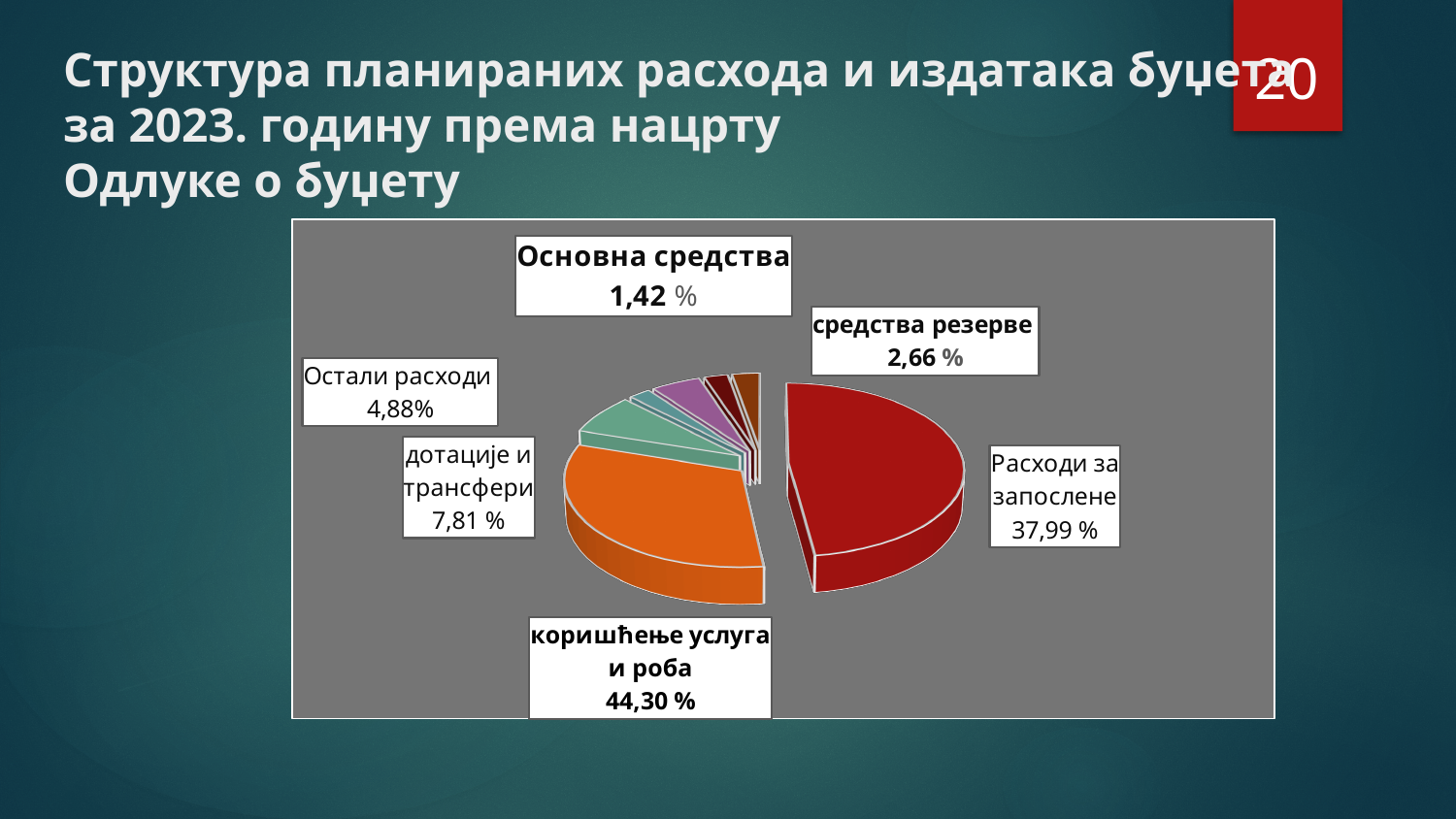
What kind of chart is shown on the slide? pie chart What share of the pie is labelled for коришћење услуга и роба? 44,30 % Which labelled category has the largest share of the pie? коришћење услуга и роба What is the difference in percentage points between the shares for коришћење услуга и роба and Расходи за запослене? 6,31 What share of the pie is labelled for Расходи за запослене? 37,99 % What share of the pie is labelled for средства резерве? 2,66 % What share of the pie is labelled for Остали расходи? 4,88% Which is larger, the share for Расходи за запослене or the share for коришћење услуга и роба? коришћење услуга и роба What share of the pie is labelled for дотације и трансфери? 7,81 % Which labelled category has the smallest share of the pie? Основна средства What share of the pie is labelled for Основна средства? 1,42 % What colour is the slice for Расходи за запослене? red